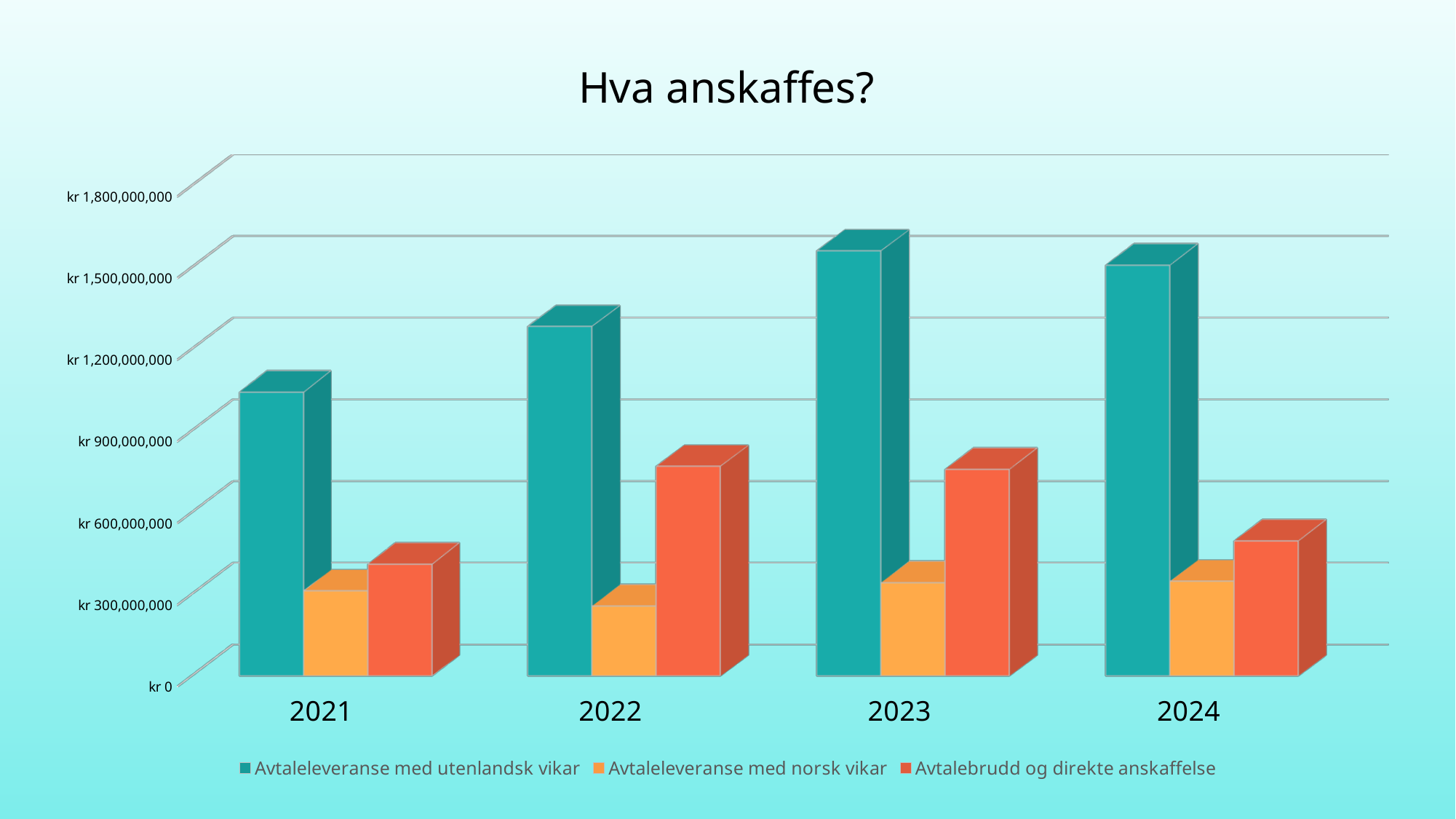
In which year is Avtalebrudd og direkte anskaffelse lowest? 2021 What kind of chart is shown on the slide? bar chart Is the value for Avtalebrudd og direkte anskaffelse in 2021 greater or less than kr 600,000,000? less In which year is Avtaleleveranse med utenlandsk vikar lowest? 2021 What is the title of the chart? Hva anskaffes? Is the value for Avtalebrudd og direkte anskaffelse in 2022 greater or less than kr 600,000,000? greater In 2021, which is larger: Avtaleleveranse med utenlandsk vikar or Avtalebrudd og direkte anskaffelse? Avtaleleveranse med utenlandsk vikar How many years are shown on the x axis? 4 Which series is shown in teal? Avtaleleveranse med utenlandsk vikar How many series does the legend list? 3 Is the value for Avtaleleveranse med utenlandsk vikar in 2022 greater or less than kr 1,200,000,000? greater